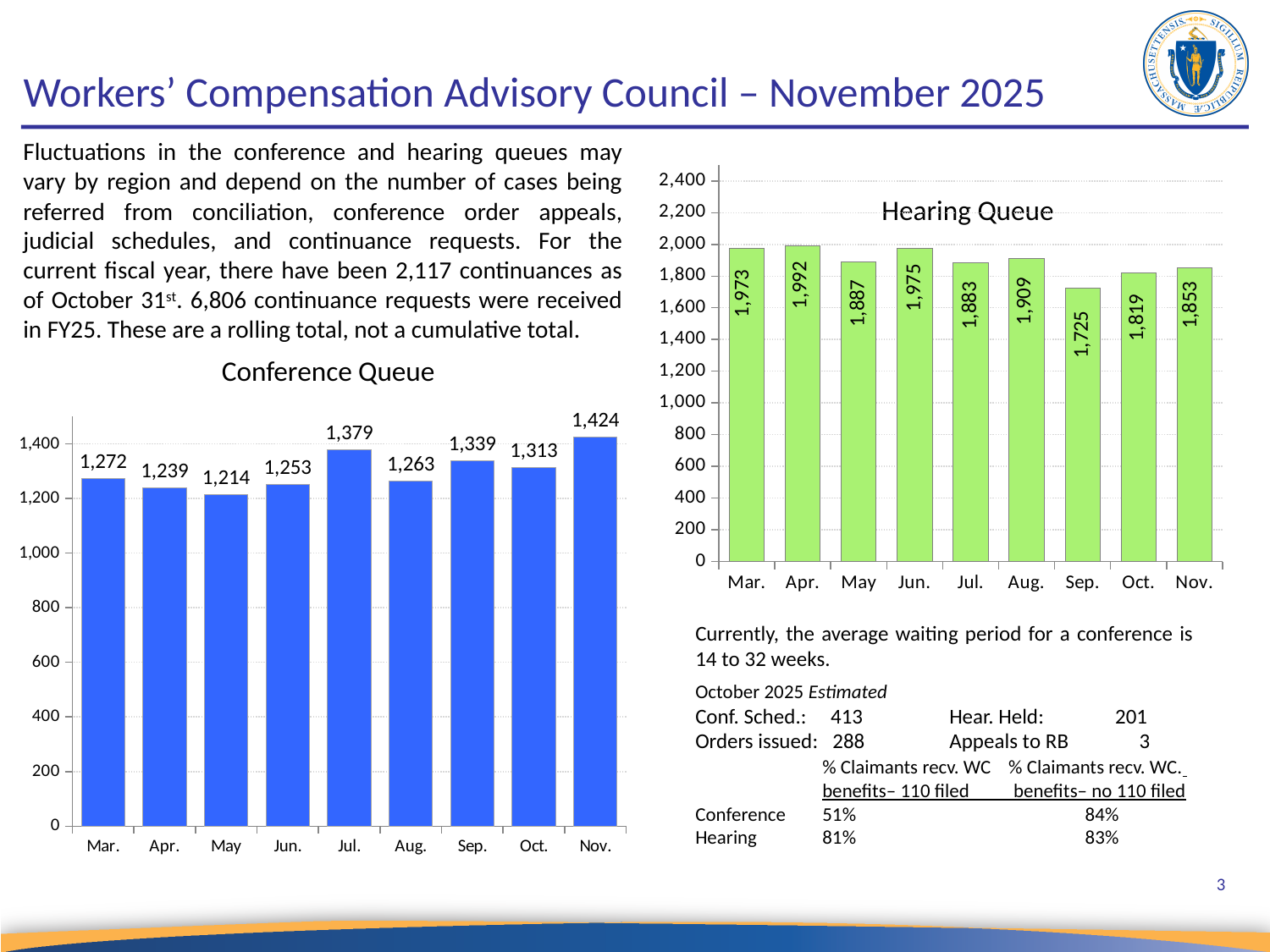
In the Conference Queue chart, what is the value for Jul.? 1,379 In the Hearing Queue chart, what is the difference between the Apr. and Sep. values? 267 In the Conference Queue chart, which month has the highest value? Nov. In the Hearing Queue chart, what is the value for Sep.? 1,725 In the Hearing Queue chart, which is larger, the value for Jun. or the value for Aug.? Jun. What kind of chart is the Hearing Queue chart? Bar chart How many months are shown in the Conference Queue chart? 9 In the Conference Queue chart, what is the difference between the Nov. and Mar. values? 152 In the Conference Queue chart, which month has the lowest value? May In the Hearing Queue chart, which month has the lowest value? Sep. What colour are the bars in the Hearing Queue chart? Green In the Hearing Queue chart, which month has the highest value? Apr.